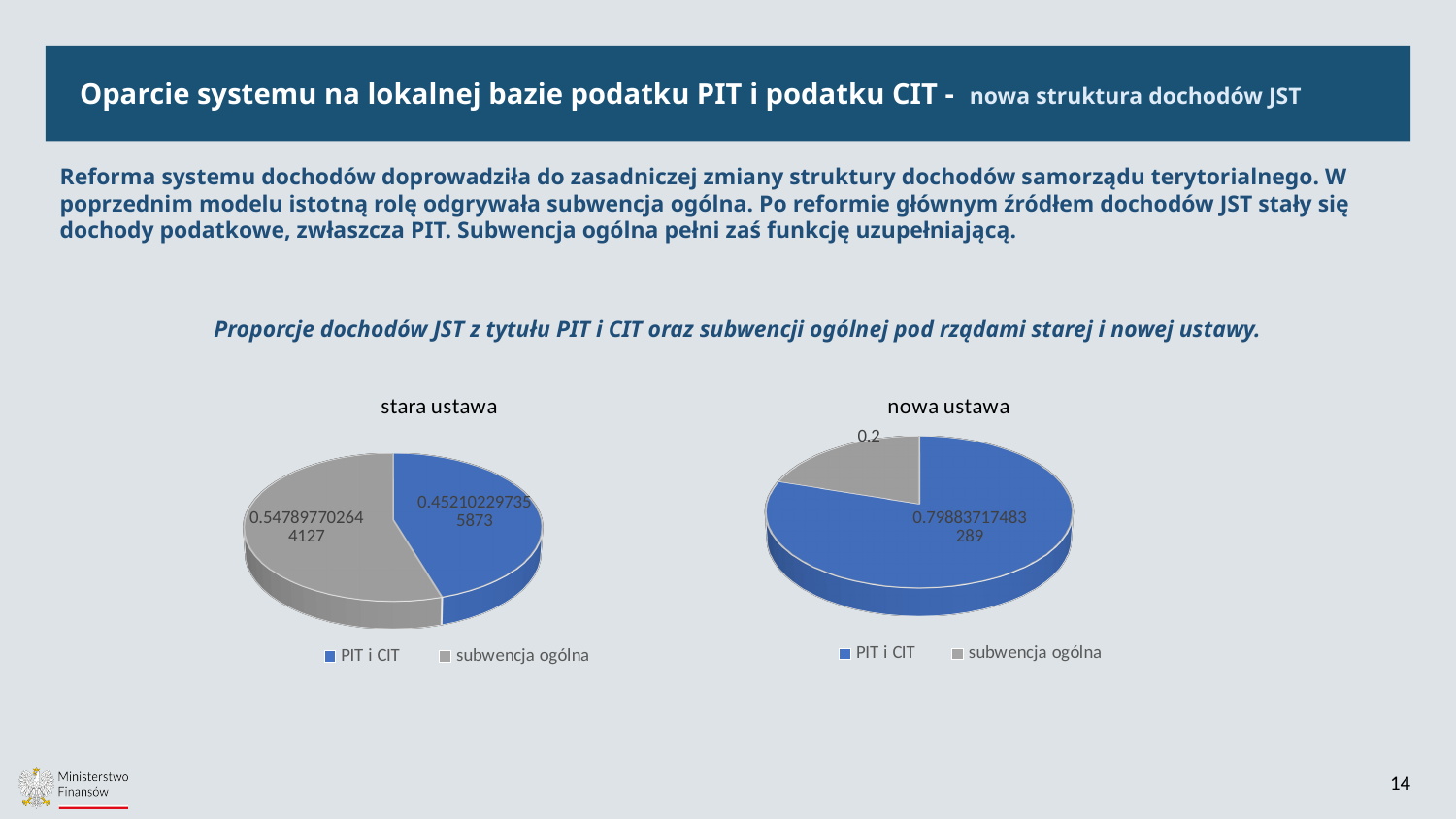
In the 'nowa ustawa' chart, which slice is the largest? PIT i CIT How many slices does the 'stara ustawa' pie chart have? 2 In the 'stara ustawa' chart, which slice is larger: PIT i CIT or subwencja ogólna? subwencja ogólna In the 'stara ustawa' chart, what is the value shown for PIT i CIT? 0.452102297355873 In the 'nowa ustawa' chart, what is the value shown for PIT i CIT? 0.79883717483289 What kind of chart is the 'stara ustawa' chart? pie chart In the 'nowa ustawa' chart, what colour is the PIT i CIT slice? blue In the 'nowa ustawa' chart, which slice is the smallest? subwencja ogólna In the 'stara ustawa' chart, what is the value shown for subwencja ogólna? 0.547897702644127 What is the title of the chart on the left? stara ustawa Which chart shows a larger share for PIT i CIT: 'stara ustawa' or 'nowa ustawa'? nowa ustawa How many entries does the legend of the 'nowa ustawa' chart list? 2